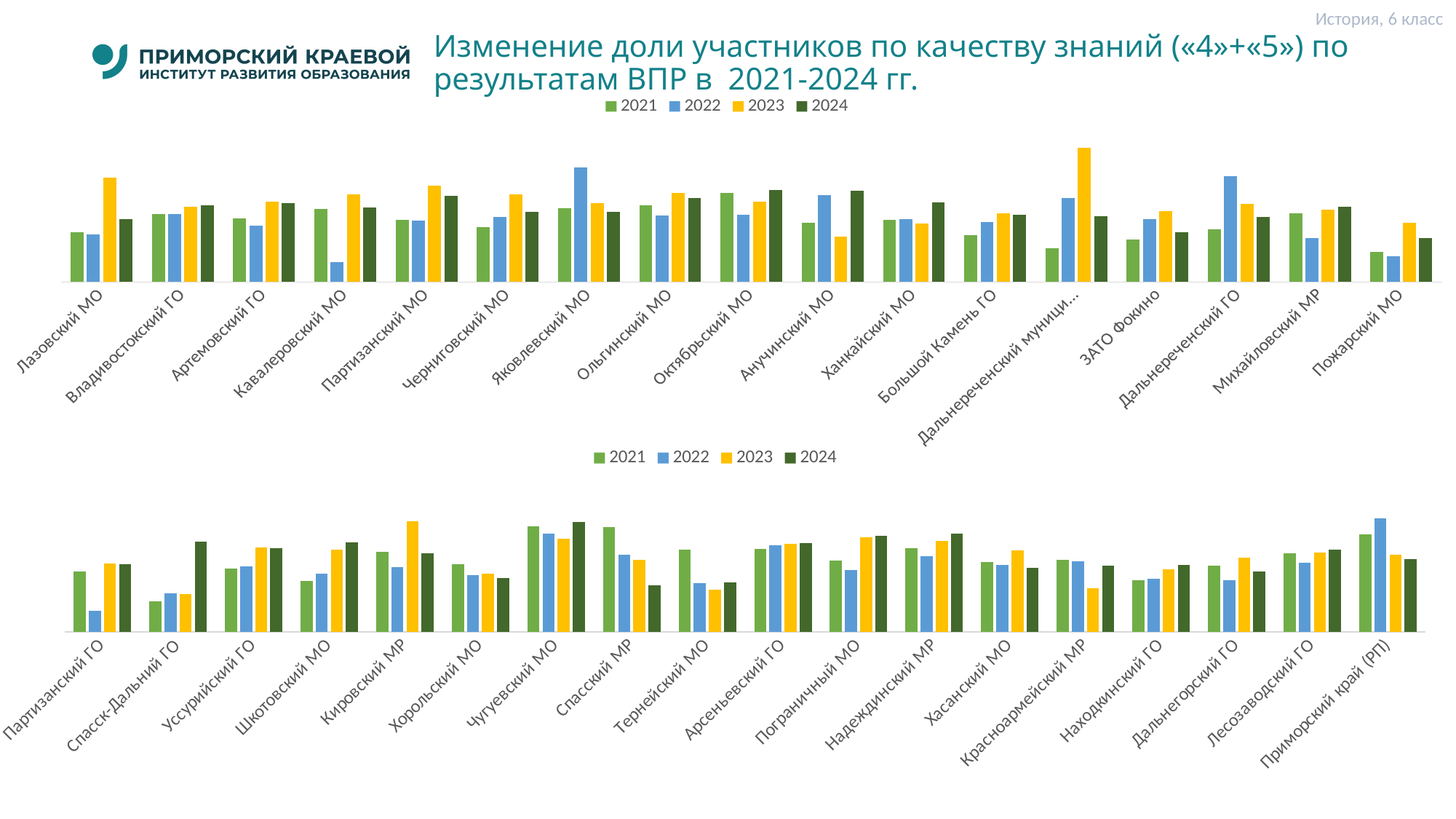
In the bottom chart, do the values for Спасский МР rise or fall from 2021 to 2024? Fall In the bottom chart, which is larger for Приморский край (РП): the 2022 value or the 2021 value? 2022 In the top chart, which year has the shortest bar for Кавалеровский МО? 2022 In the bottom chart, which year has the shortest bar for Партизанский ГО? 2022 Which years are listed in the legend of the bottom chart? 2021, 2022, 2023, 2024 How many categories are shown on the x axis of the bottom chart? 18 How many categories are shown on the x axis of the top chart? 17 What kind of chart is the top chart on the slide? Bar chart How many series does the legend of the top chart list? 4 In the top chart, which year has the tallest bar for Яковлевский МО? 2022 In the top chart, which year has the tallest bar for Лазовский МО? 2023 In the bottom chart, which year has the tallest bar for Спасск-Дальний ГО? 2024